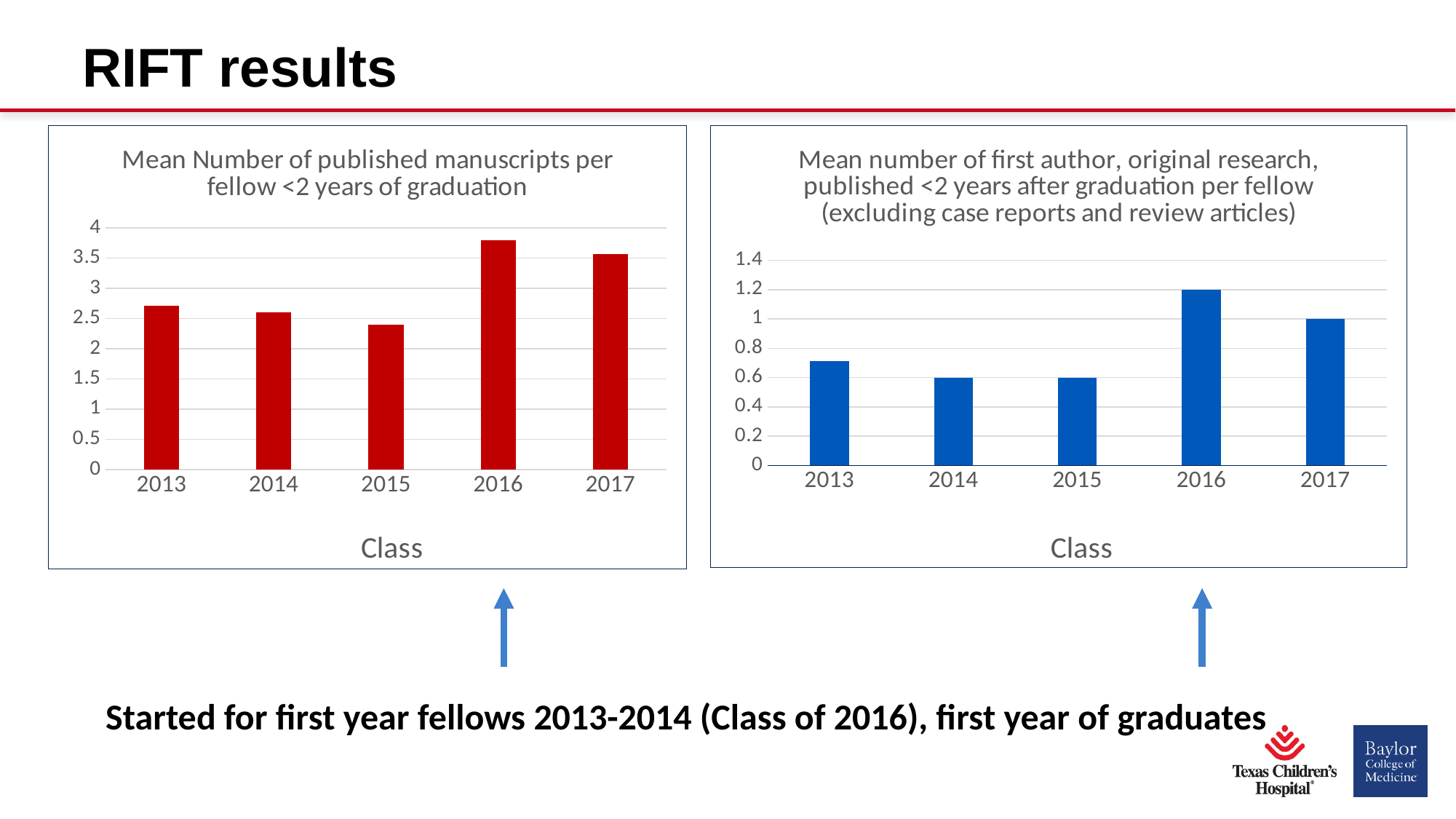
In the right chart, 'Mean number of first author, original research, published <2 years after graduation per fellow', is the value for 2014 greater or less than 0.8? less What is the x-axis title of the right chart, 'Mean number of first author, original research, published <2 years after graduation per fellow'? Class In the left chart, 'Mean Number of published manuscripts per fellow <2 years of graduation', which class has the highest value? 2016 What kind of chart is the left chart, 'Mean Number of published manuscripts per fellow <2 years of graduation'? bar chart How many classes are shown on the x axis of the left chart, 'Mean Number of published manuscripts per fellow <2 years of graduation'? 5 In the right chart, 'Mean number of first author, original research, published <2 years after graduation per fellow', is the value for 2013 greater or less than 0.6? greater In the left chart, 'Mean Number of published manuscripts per fellow <2 years of graduation', is the value for 2015 greater or less than 2.5? less In the right chart, 'Mean number of first author, original research, published <2 years after graduation per fellow', which class has the highest value? 2016 In the left chart, 'Mean Number of published manuscripts per fellow <2 years of graduation', which is larger, the value for 2013 or the value for 2017? 2017 In the left chart, 'Mean Number of published manuscripts per fellow <2 years of graduation', which class has the lowest value? 2015 In the right chart, 'Mean number of first author, original research, published <2 years after graduation per fellow', which is larger, the value for 2016 or the value for 2017? 2016